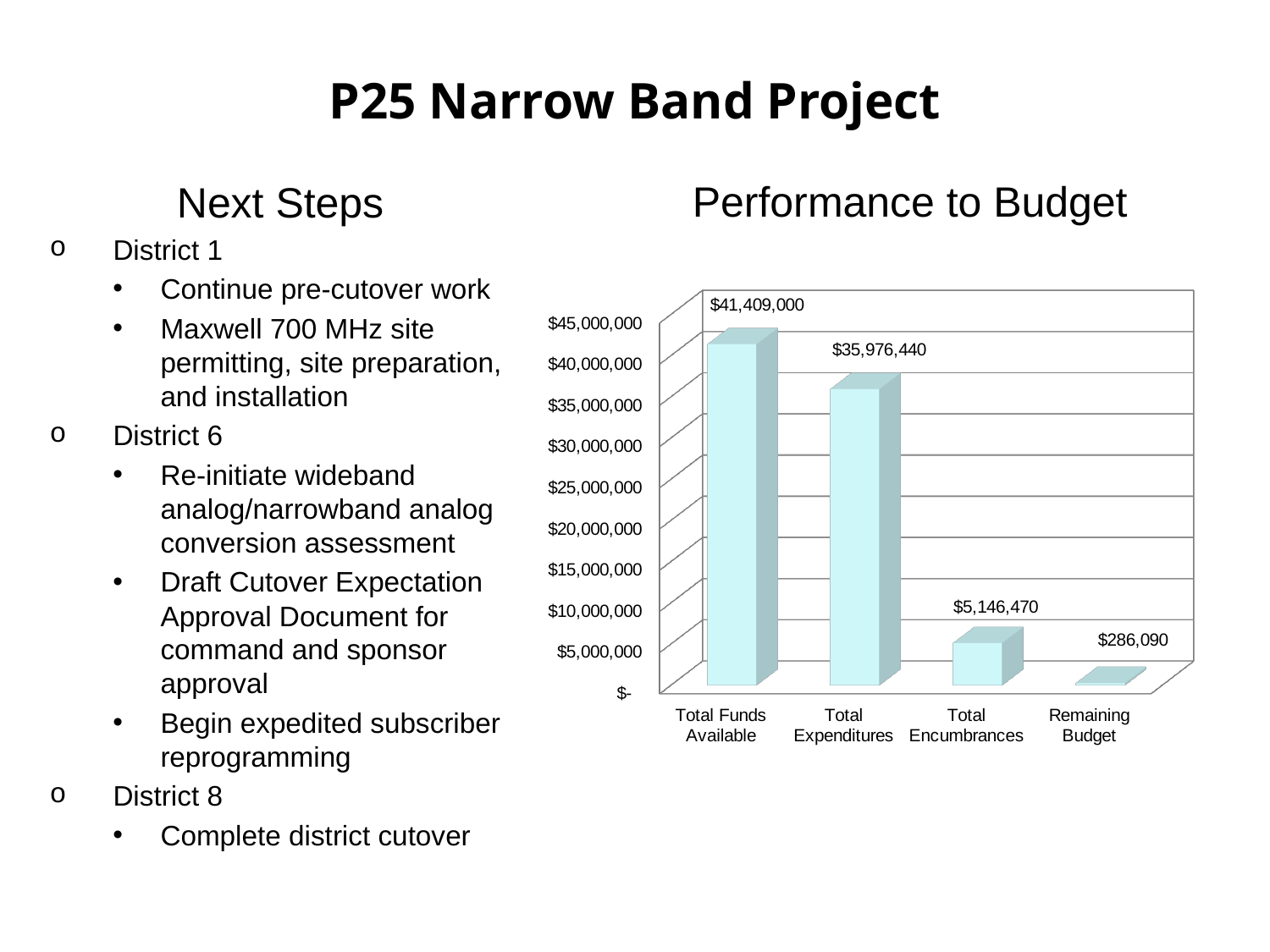
Which category has the highest value? Total Funds Available What is the value for Remaining Budget? $286,090 What is the title of the chart? Performance to Budget What is the value for Total Encumbrances? $5,146,470 Which is larger, Total Expenditures or Total Encumbrances? Total Expenditures What is the difference between Total Funds Available and Total Expenditures? $5,432,560 What kind of chart is shown on the slide? Bar chart What is the value for Total Expenditures? $35,976,440 Which category has the lowest value? Remaining Budget What is the difference between Total Encumbrances and Remaining Budget? $4,860,380 What is the value for Total Funds Available? $41,409,000 How many categories are shown on the chart? 4